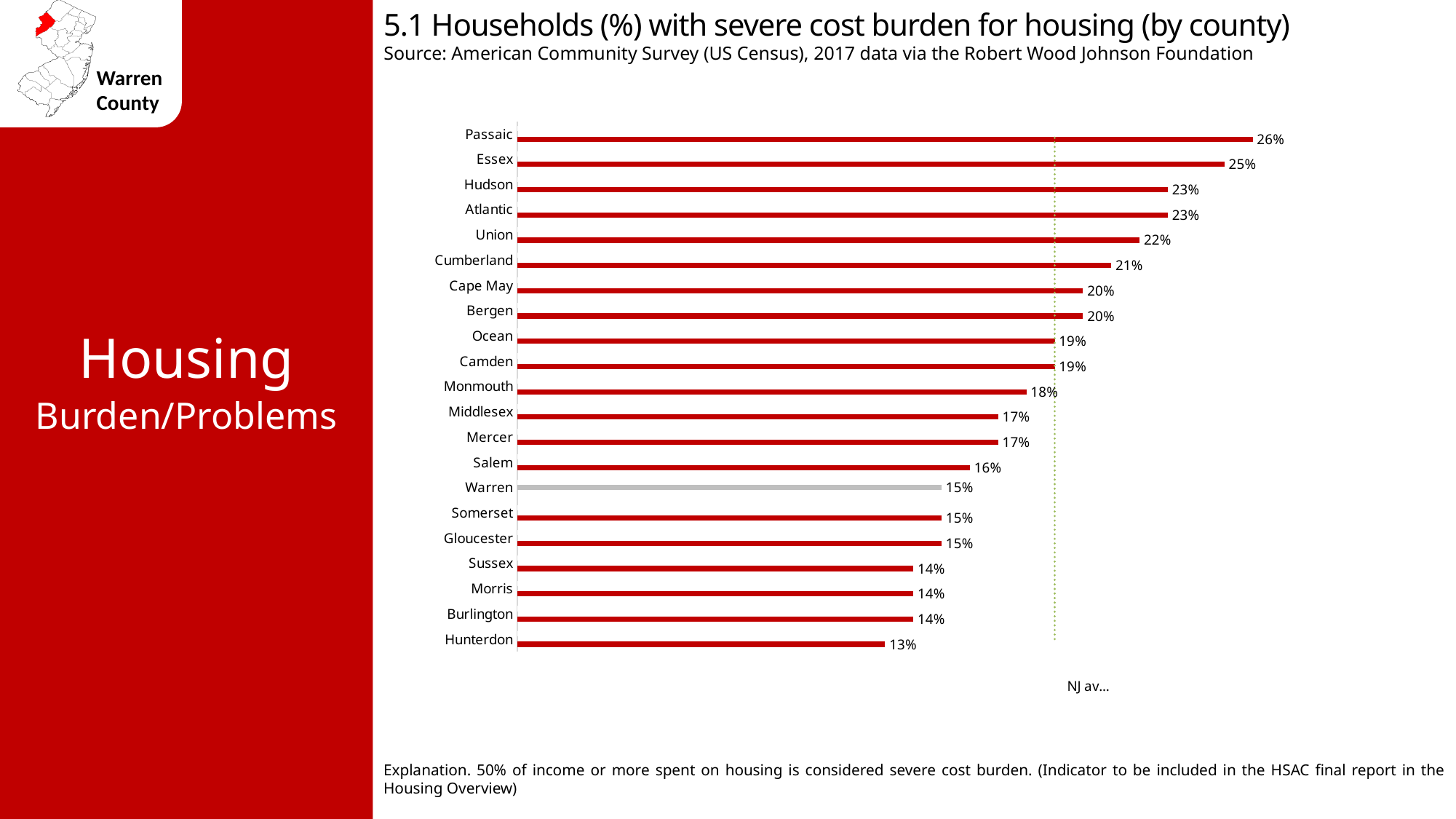
What percentage of households in Warren County have a severe housing cost burden? 15% What is the value shown for Passaic? 26% Which county has the lowest percentage of households with severe housing cost burden? Hunterdon Which county has the highest percentage of households with severe housing cost burden? Passaic What is the difference between the values for Passaic and Hunterdon? 13% What type of chart is used on this slide? Bar chart Which county's bar is shown in grey rather than red? Warren What is the difference between the values for Essex and Warren? 10% How many counties are shown in the chart? 21 Which has a higher value, Hudson or Monmouth? Hudson Which has a higher value, Union or Salem? Union What is the value shown for Cumberland? 21%